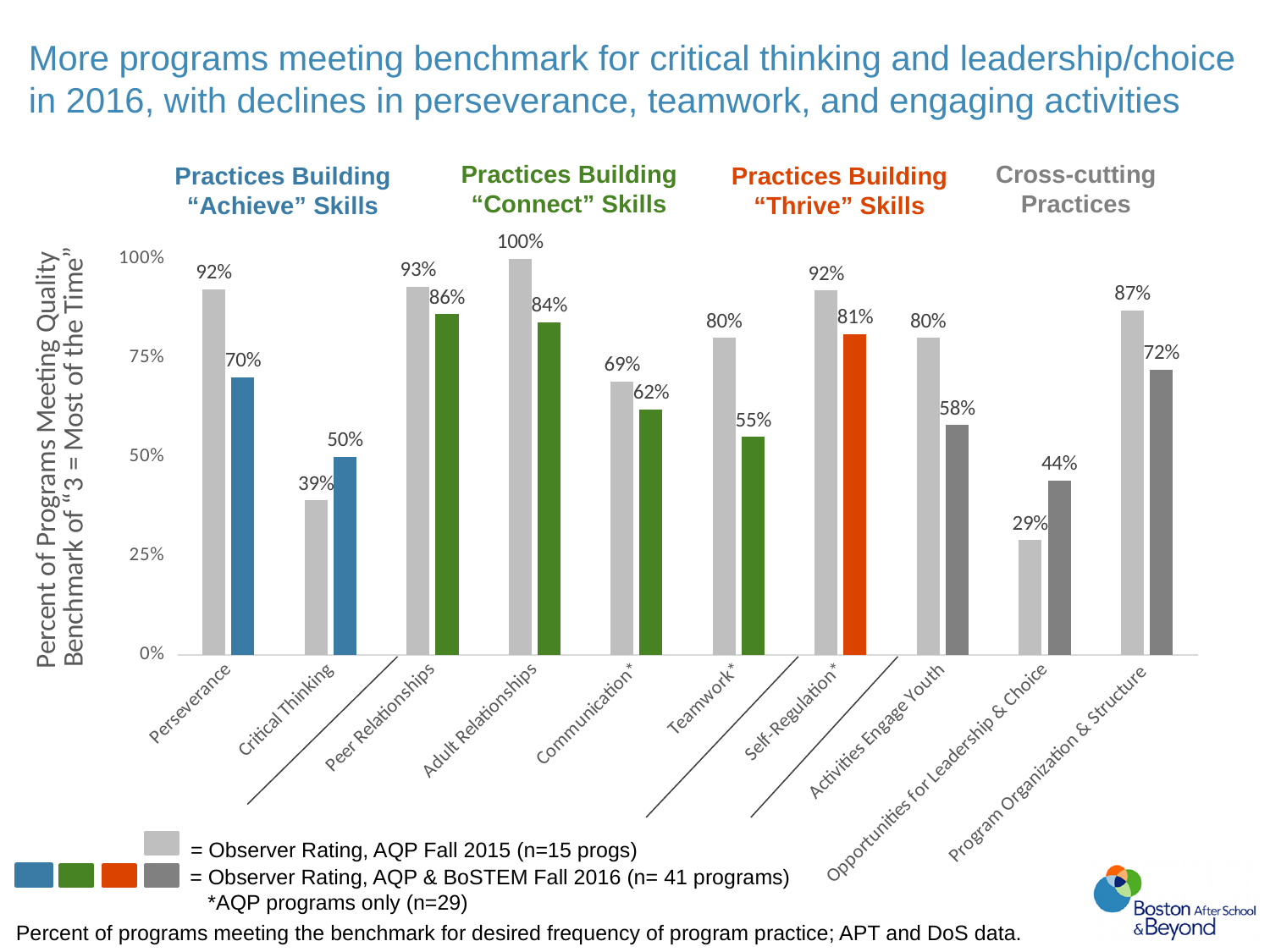
What kind of chart is shown on the slide? Bar chart What is the Fall 2016 value for Teamwork? 55% How many series does the legend list? 2 How many categories are shown on the x axis? 10 What is the Fall 2016 value for Program Organization & Structure? 72% What is the difference between the Fall 2015 and Fall 2016 values for Teamwork? 25% What is the Fall 2015 value for Perseverance? 92% Which category has the lowest Fall 2016 value? Opportunities for Leadership & Choice Which is larger for Critical Thinking: the Fall 2015 value or the Fall 2016 value? Fall 2016 What is the Fall 2015 value for Opportunities for Leadership & Choice? 29% Which category has the highest Fall 2015 value? Adult Relationships What is the Fall 2016 value for Critical Thinking? 50%